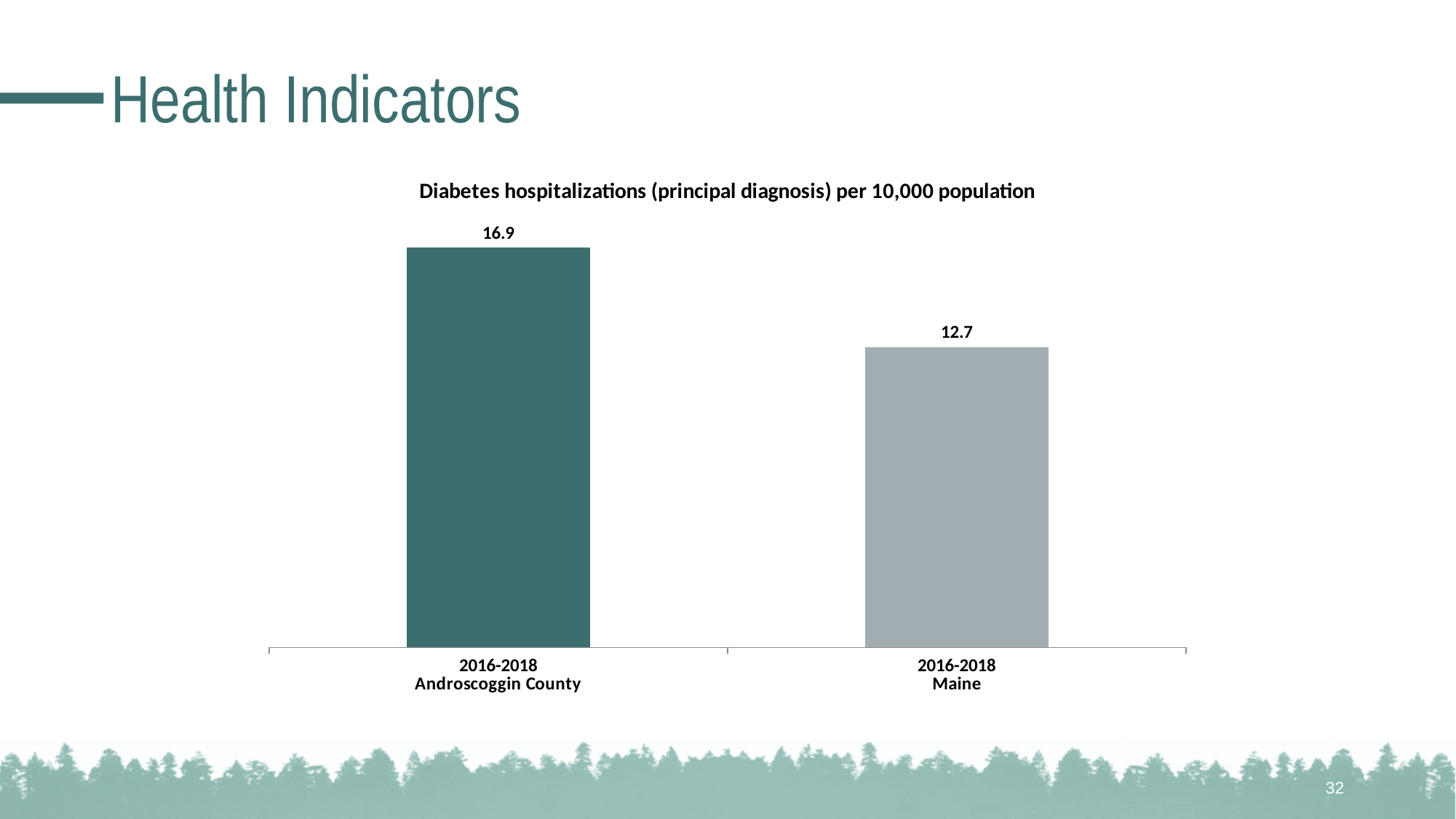
How many bars are shown in the chart? 2 What is the difference between the Androscoggin County value and the Maine value? 4.2 Which category has the highest value? Androscoggin County What time period do both bars cover? 2016-2018 What is the value for Maine (2016-2018)? 12.7 What is the title of the chart? Diabetes hospitalizations (principal diagnosis) per 10,000 population What kind of chart is shown on the slide? Bar chart Which category has the lowest value? Maine Which is larger, the value for Androscoggin County or the value for Maine? Androscoggin County What is the value for Androscoggin County (2016-2018)? 16.9